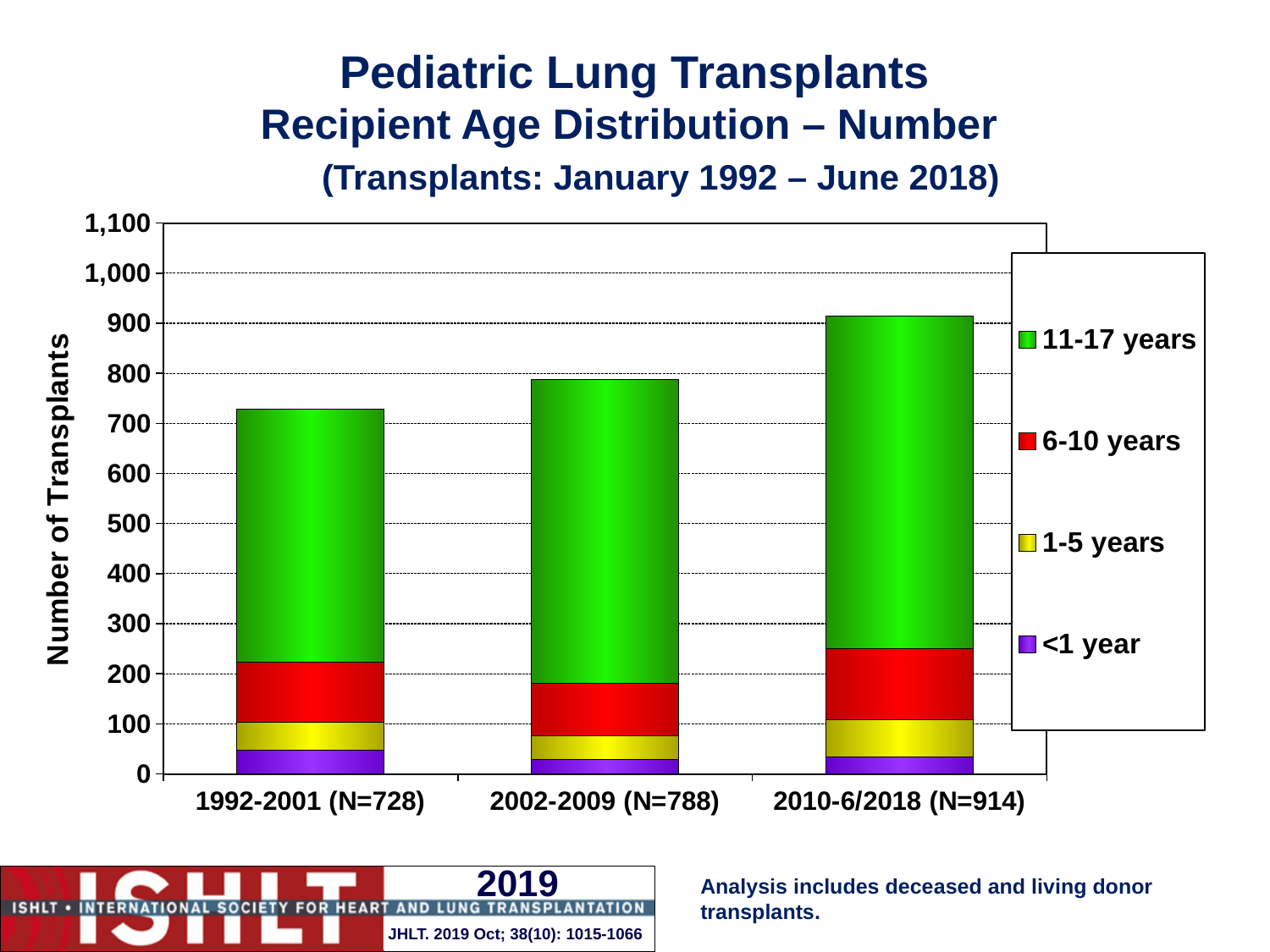
What is the total number of transplants for the 2010-6/2018 period? 914 What is the difference between the total transplants in 2010-6/2018 and in 1992-2001? 186 Which period has the highest total number of transplants? 2010-6/2018 What is the total number of transplants for the 2002-2009 period? 788 Which period has the lowest total number of transplants? 1992-2001 What kind of chart is shown on the slide? Stacked bar chart Which colour represents the 11-17 years group in the legend? Green Do the total numbers of transplants rise or fall across the periods from left to right? Rise How many age groups does the legend list? 4 How many time periods (categories) are shown on the x axis? 3 What is the total number of transplants for the 1992-2001 period? 728 Is the number of transplants for the <1 year group in 1992-2001 greater or less than 100? less